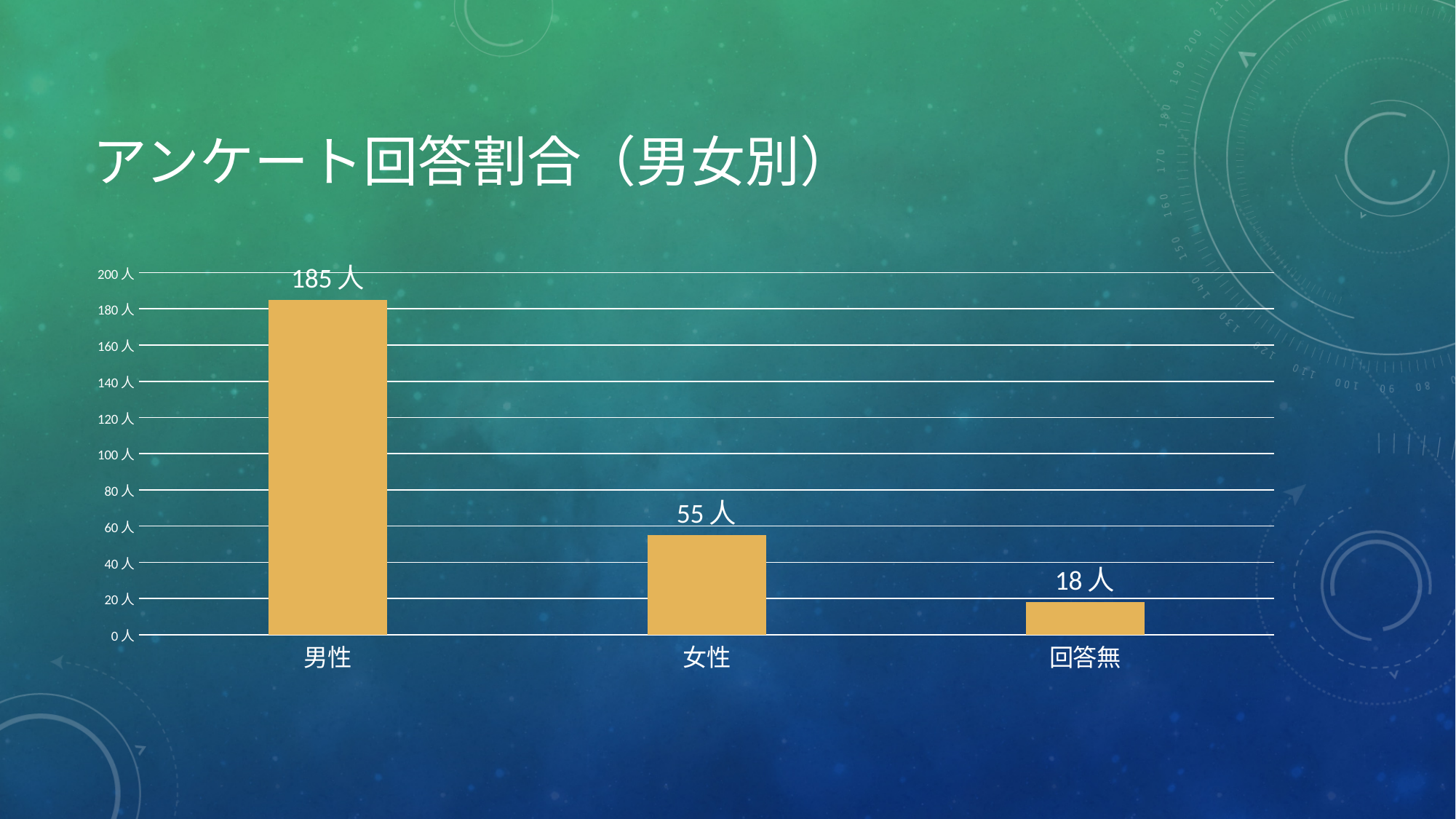
Is the value for 男性 greater or less than 160? greater What is the value for 女性? 55 人 What is the value for 男性? 185 人 What is the difference between the values for 男性 and 女性? 130 人 How many categories are shown on the x axis? 3 Which is larger, the value for 女性 or the value for 回答無? 女性 What kind of chart is shown on the slide? bar chart Which category has the lowest value? 回答無 What is the value for 回答無? 18 人 Which category has the highest value? 男性 What is the difference between the values for 女性 and 回答無? 37 人 What is the title of the slide? アンケート回答割合（男女別）